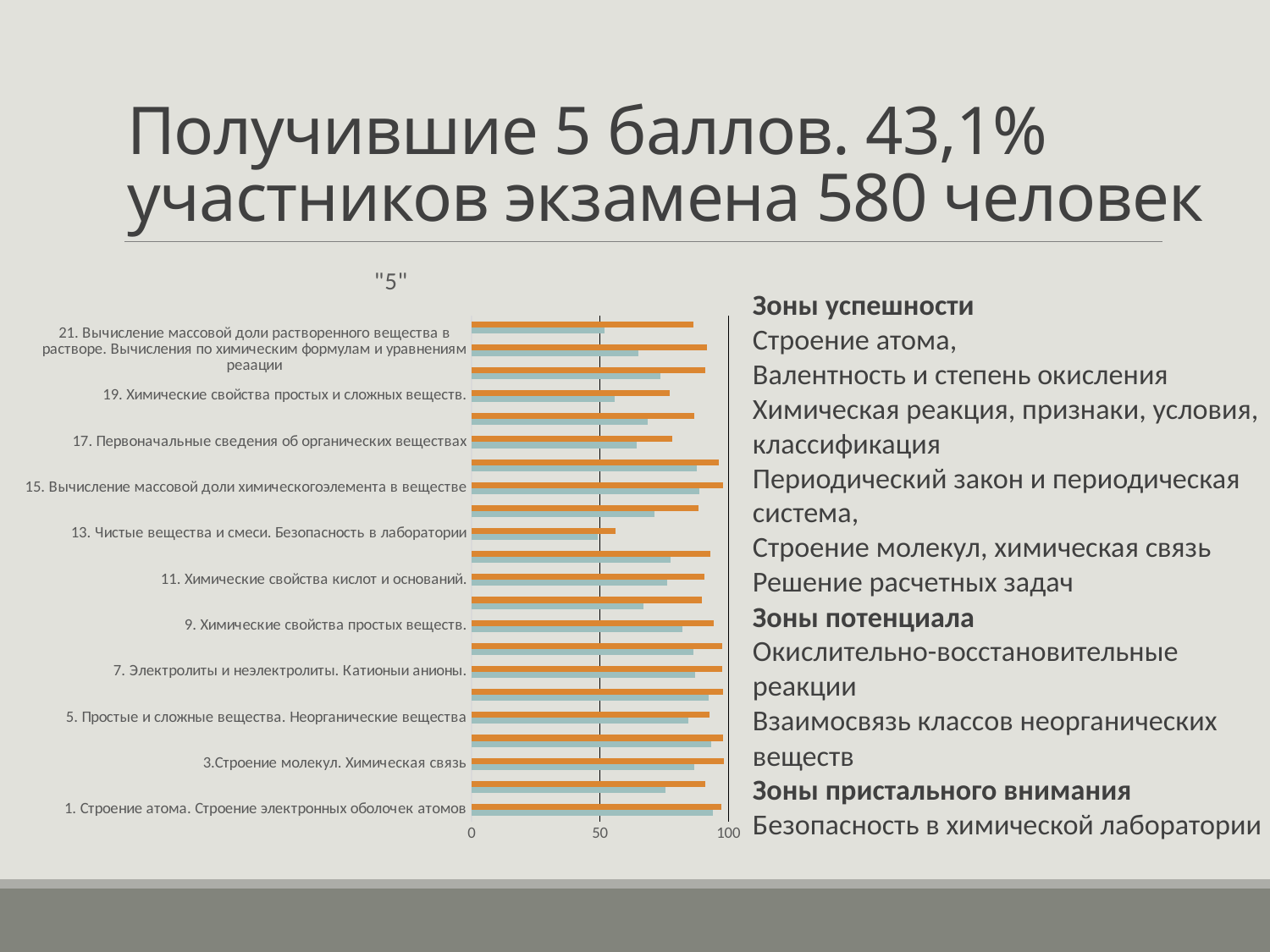
Is the teal bar for "13. Чистые вещества и смеси. Безопасность в лаборатории" greater or less than 100? less Is the orange bar for "15. Вычисление массовой доли химическогоэлемента в веществе" greater or less than 50? greater Which has the larger teal bar: "3.Строение молекул. Химическая связь" or "13. Чистые вещества и смеси. Безопасность в лаборатории"? 3.Строение молекул. Химическая связь How many categories (topics) are plotted in the chart? 22 Which has the larger orange bar: "1. Строение атома. Строение электронных оболочек атомов" or "13. Чистые вещества и смеси. Безопасность в лаборатории"? 1. Строение атома. Строение электронных оболочек атомов How many data series are plotted for each category in the chart? 2 What is the title of the chart? "5" Is the orange bar for "1. Строение атома. Строение электронных оболочек атомов" greater or less than 50? greater What kind of chart is shown on the slide? bar chart Which category has the lowest orange bar in the chart? 13. Чистые вещества и смеси. Безопасность в лаборатории For "13. Чистые вещества и смеси. Безопасность в лаборатории", which bar is longer, the orange one or the teal one? orange What is the highest value shown on the horizontal axis of the chart? 100